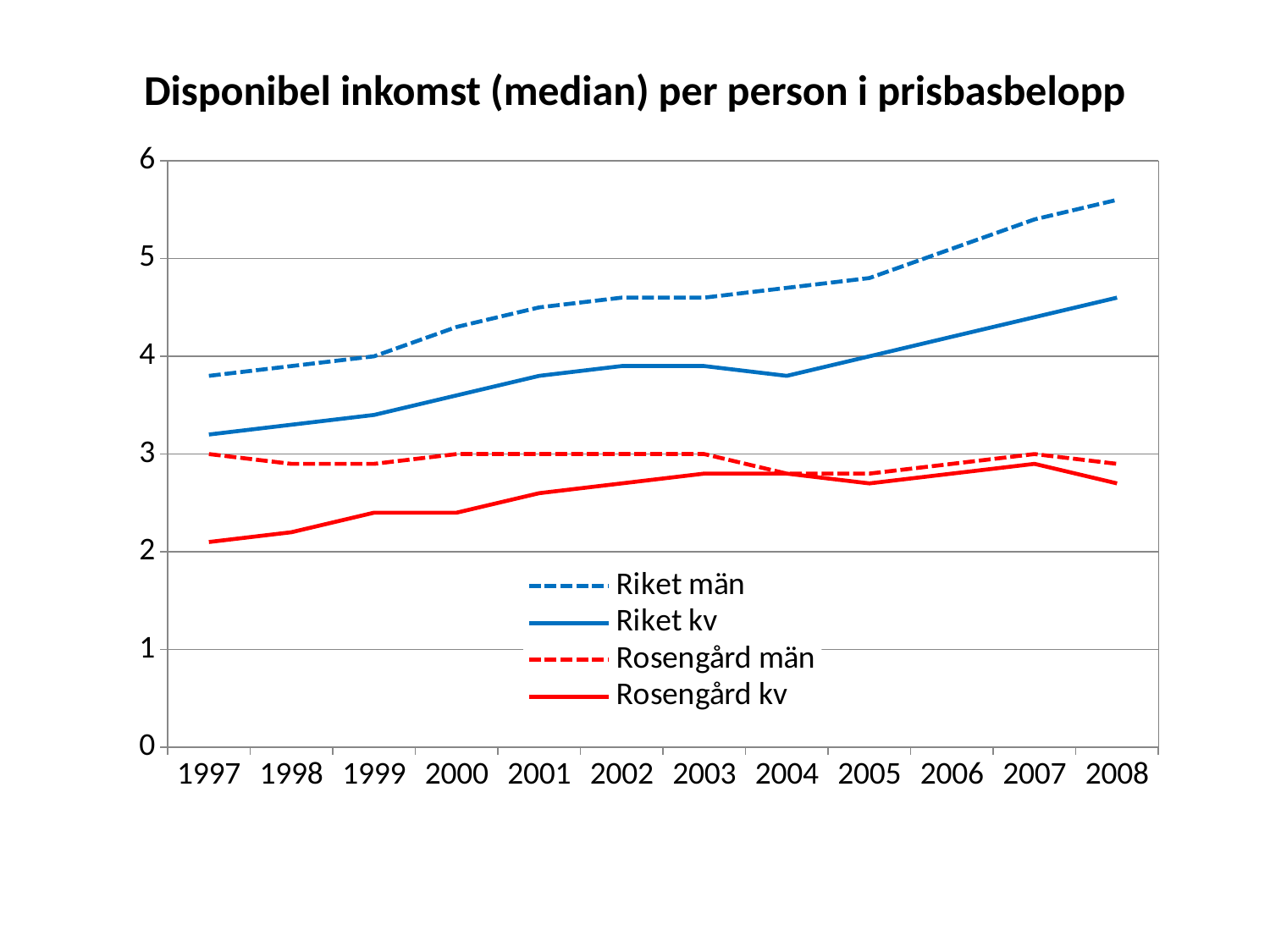
Which series is drawn as a dashed blue line? Riket män Which series has the highest value in 2008? Riket män Is the value for Riket män in 2005 greater or less than 4? greater What kind of chart is shown on the slide? line chart Does the Riket kv series rise or fall from 1997 to 2008? rise What is the title of the chart? Disponibel inkomst (median) per person i prisbasbelopp Is the value for Riket kv in 1997 greater or less than 3? greater Which series has the lowest value in 1997? Rosengård kv How many years are shown on the x axis? 12 Is the value for Rosengård kv in 2008 greater or less than 3? less How many series does the legend list? 4